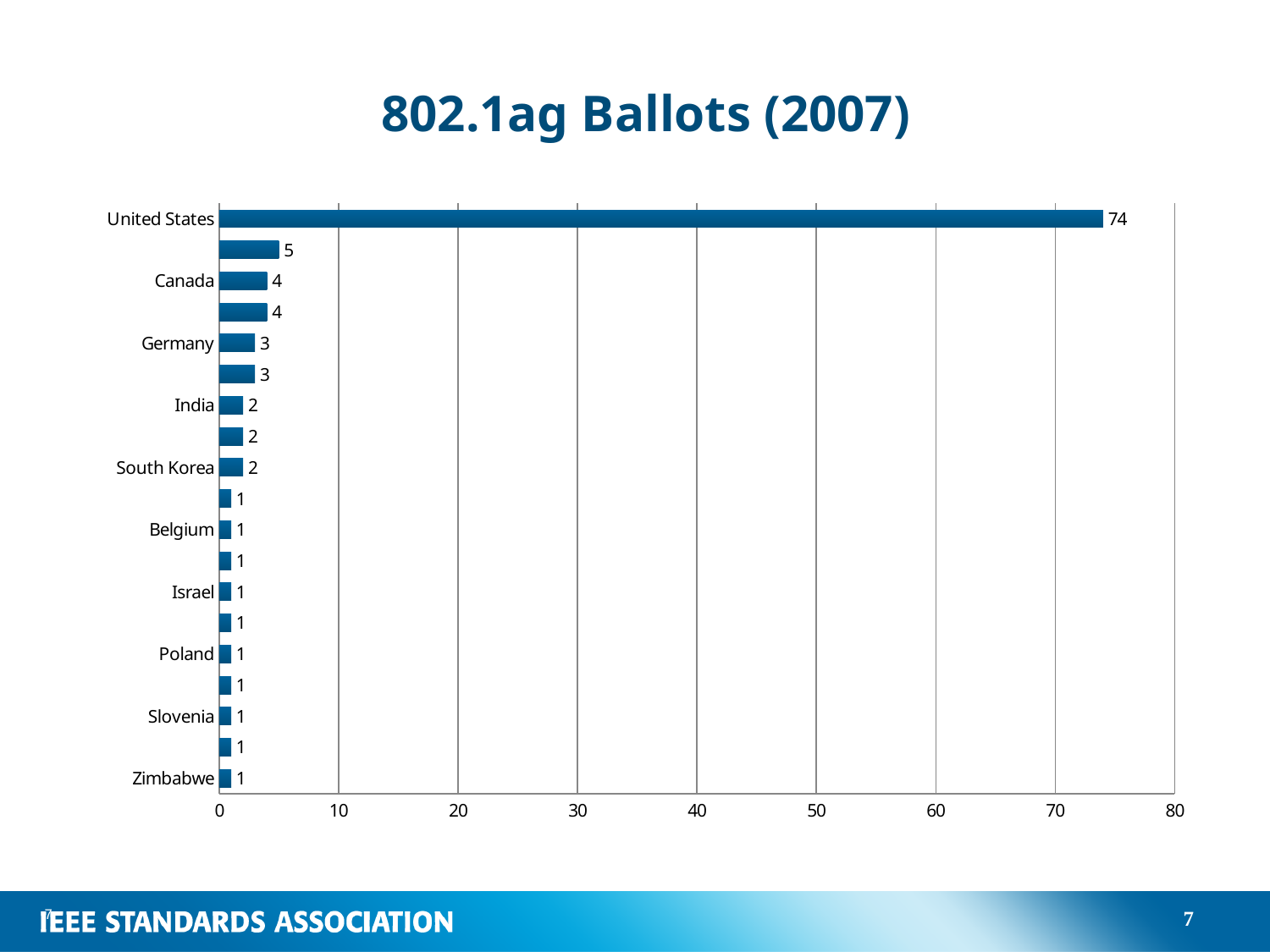
How many ballots does the chart show for the United States? 74 What is the value for Canada? 4 What is the value for South Korea? 2 What is the value for India? 2 What is the difference between the values for the United States and Canada? 70 What is the value for Germany? 3 What is the value for Zimbabwe? 1 What kind of chart is shown on the slide? bar chart What is the title of the chart? 802.1ag Ballots (2007) Which category has the highest value? United States How many bars are plotted in the chart? 19 Which is larger, the value for Canada or the value for Germany? Canada